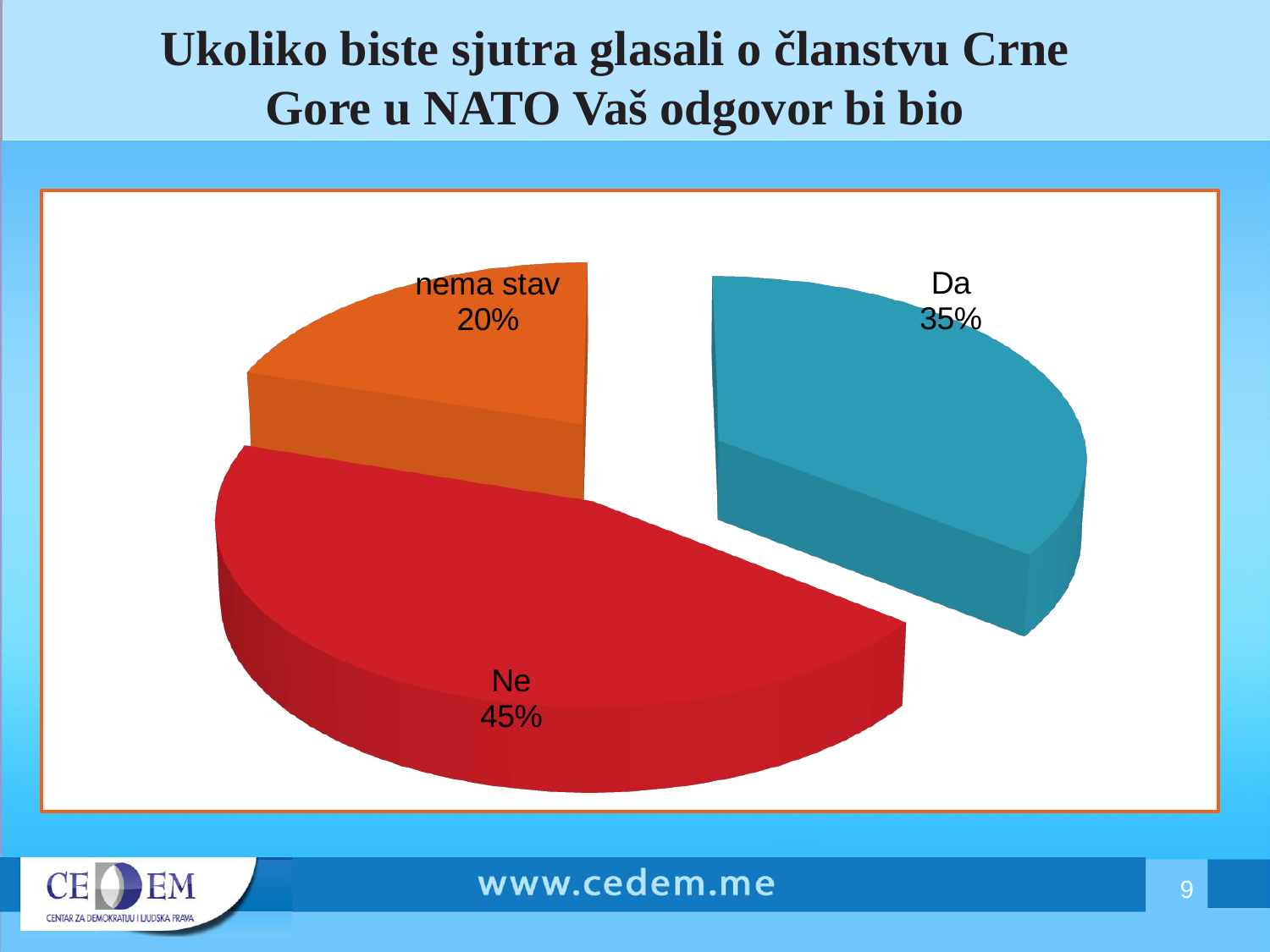
What is the difference in percentage points between "Da" and "nema stav"? 15 What kind of chart is shown on the slide? Pie chart What percentage of respondents answered "Ne"? 45% What percentage of respondents answered "Da"? 35% How many slices does the pie chart have? 3 Which response has the smallest share of the pie? nema stav Which response has the largest share of the pie? Ne What colour is the "Ne" slice? Red Which is larger, the share for "Da" or the share for "Ne"? Ne What percentage of respondents have no opinion ("nema stav")? 20% What colour is the "Da" slice? Blue What is the difference in percentage points between "Ne" and "Da"? 10